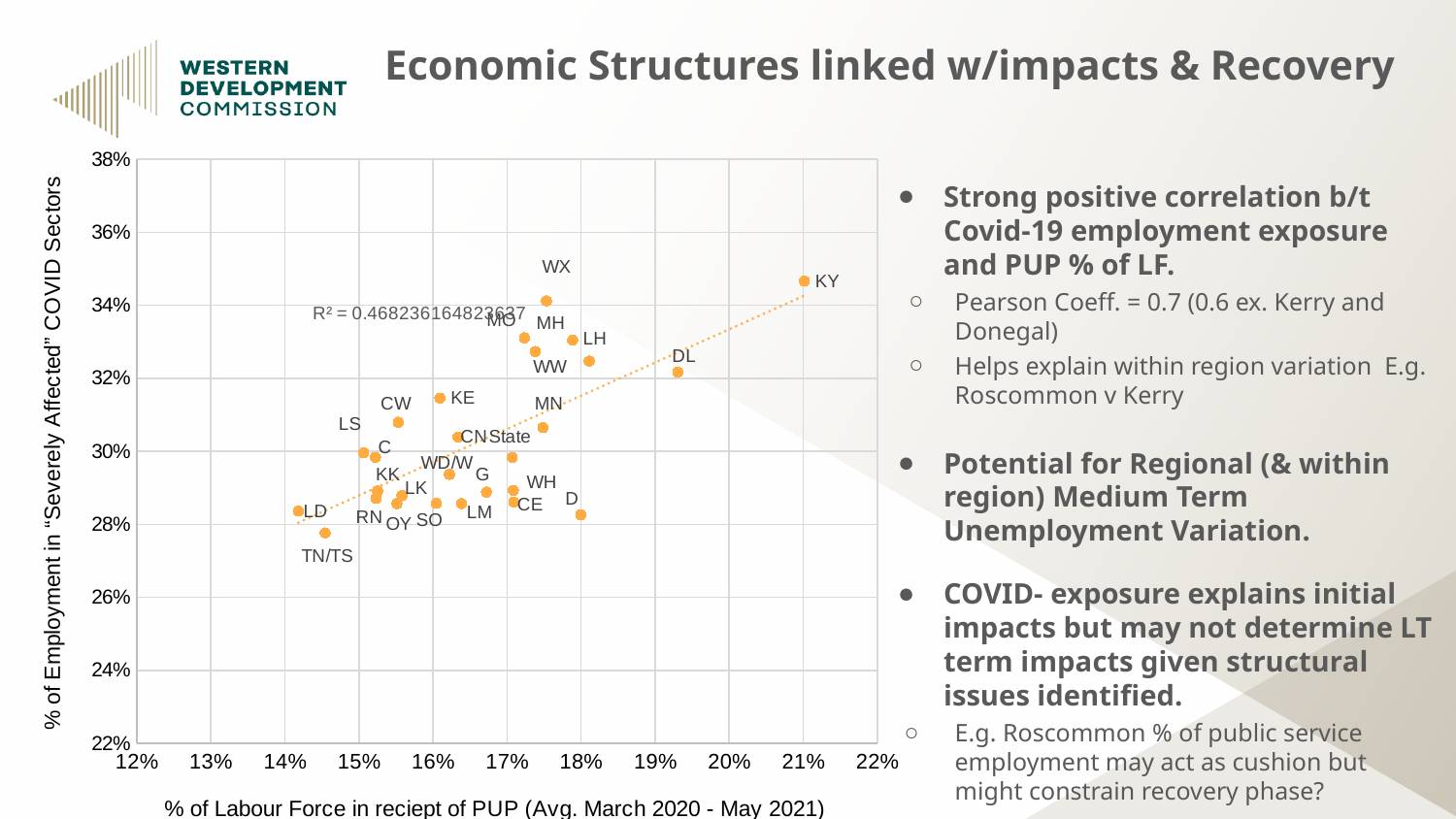
What R² value is printed on the chart? 0.468236164823637 What kind of chart is shown on the slide? scatter chart Which labelled point has the lowest value on the vertical axis (% of Employment in Severely Affected COVID Sectors)? TN/TS Do the plotted points generally rise or fall as the horizontal-axis value increases? rise Which labelled point has the highest value on the horizontal axis (% of Labour Force in receipt of PUP)? KY Is the vertical-axis value for WX greater or less than 33%? greater Is the horizontal-axis value for KY greater or less than 20%? greater Is the horizontal-axis value for LD greater or less than 15%? less Which labelled point has the lowest value on the horizontal axis? LD What is the title of the horizontal axis of the chart? % of Labour Force in reciept of PUP (Avg. March 2020 - May 2021) Which point has a higher vertical-axis value, DL or CW? DL